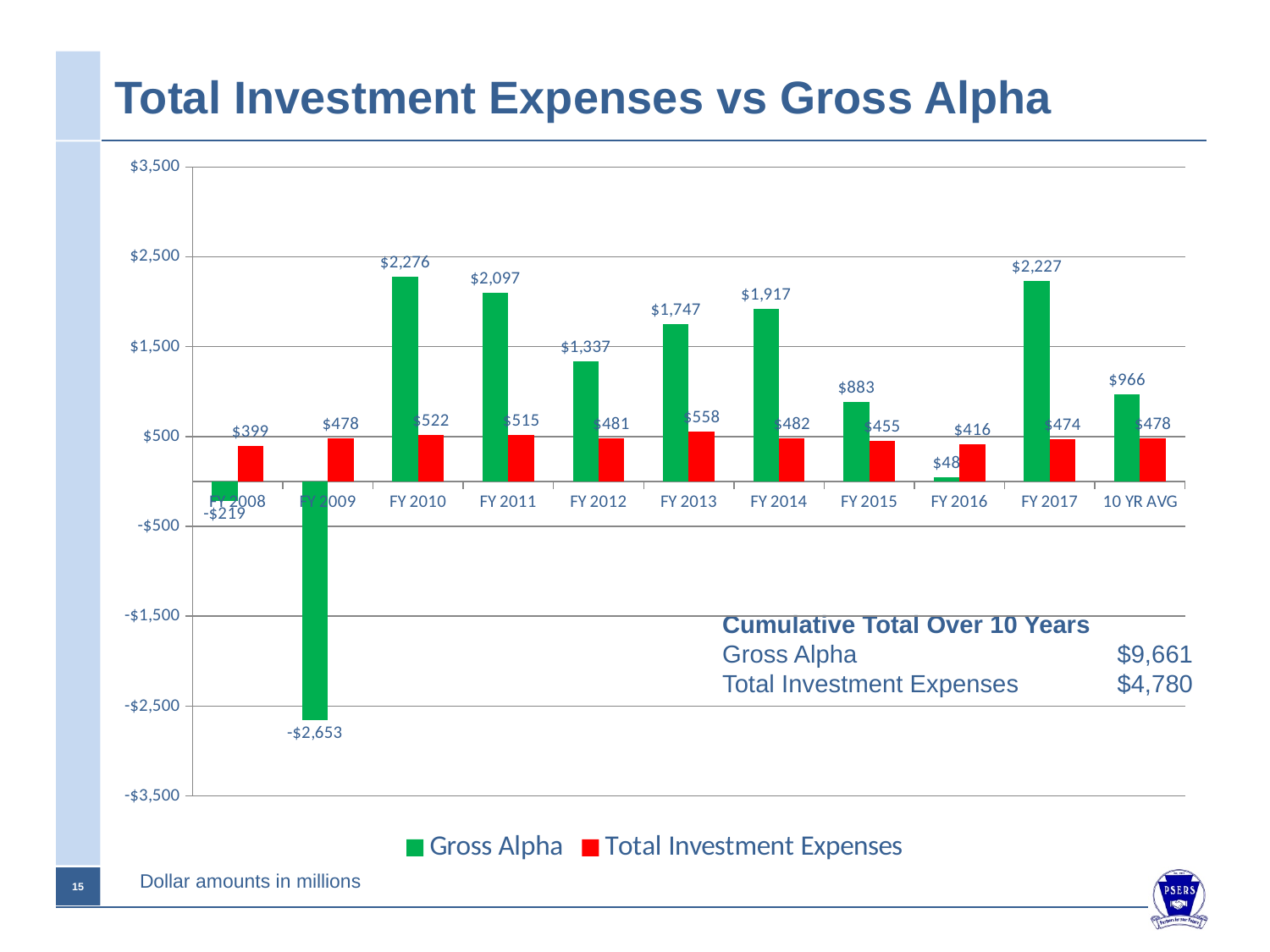
What is the Total Investment Expenses value for FY 2013? $558 What kind of chart is shown on the slide? Bar chart Which fiscal year has the highest Gross Alpha? FY 2010 Which category has the lowest Total Investment Expenses? FY 2008 Which category has the highest Total Investment Expenses? FY 2013 How many categories are shown on the x axis? 11 What is the Gross Alpha value for FY 2010? $2,276 What is the Gross Alpha value for the 10 YR AVG category? $966 How many series does the legend list? 2 Which fiscal year has the lowest Gross Alpha? FY 2009 What is the difference between Gross Alpha and Total Investment Expenses in FY 2017? $1,753 In FY 2015, which is larger: Gross Alpha or Total Investment Expenses? Gross Alpha